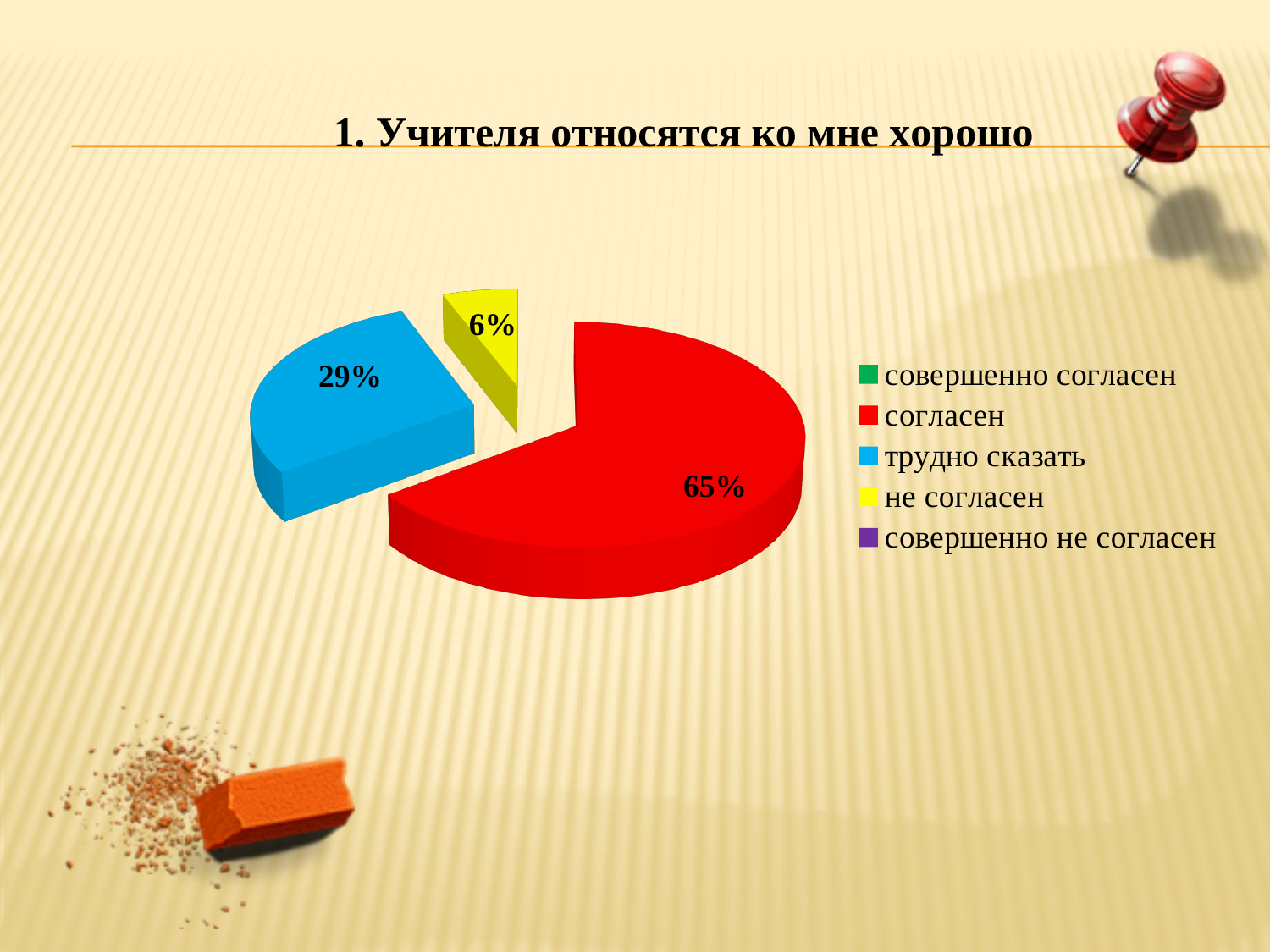
Which slice is larger, "трудно сказать" or "не согласен"? трудно сказать How many slices of the pie have a percentage label? 3 Which of the labelled slices has the smallest share? не согласен What percentage is shown for the "трудно сказать" slice? 29% What is the title of the slide? 1. Учителя относятся ко мне хорошо What is the difference in percentage points between the "согласен" and "трудно сказать" slices? 36 What colour represents "трудно сказать" in the legend? blue What kind of chart is shown on the slide? pie chart What percentage is shown for the "не согласен" slice? 6% What percentage of the pie is labelled for the "согласен" slice? 65% Which response category has the largest share of the pie? согласен How many entries does the legend list? 5